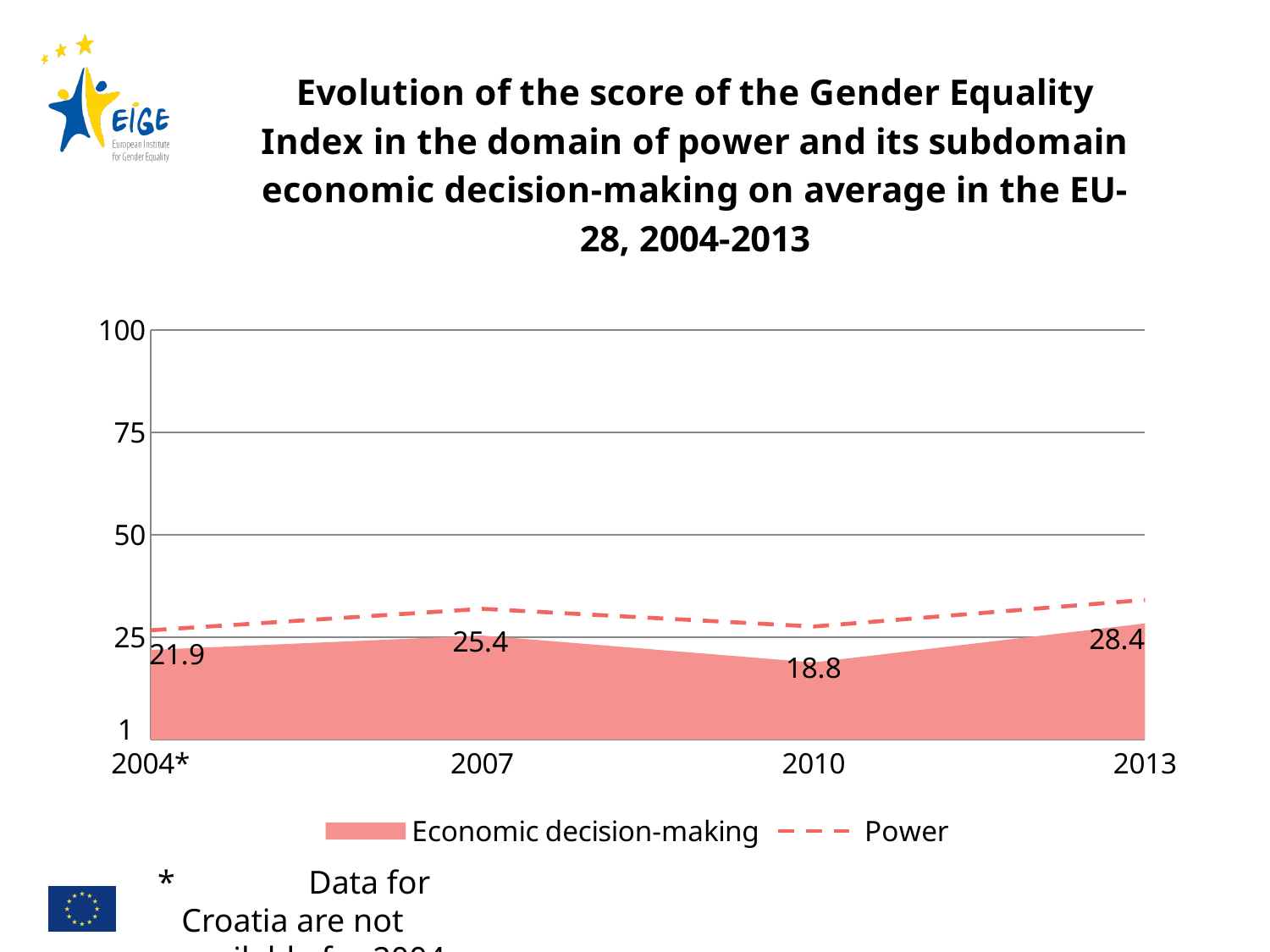
How many series does the legend list? 2 Is the value for Power in 2013 greater or less than 25? greater What is the Economic decision-making score in 2007? 25.4 Which is larger, the Economic decision-making score in 2007 or in 2004*? 2007 What is the Economic decision-making score in 2004*? 21.9 What is the Economic decision-making score in 2013? 28.4 In which year is the Economic decision-making score highest? 2013 Does the Economic decision-making score rise or fall from 2010 to 2013? rise In which year is the Economic decision-making score lowest? 2010 What is the Economic decision-making score in 2010? 18.8 How many years are shown on the x axis? 4 What is the difference between the Economic decision-making scores in 2013 and 2010? 9.6